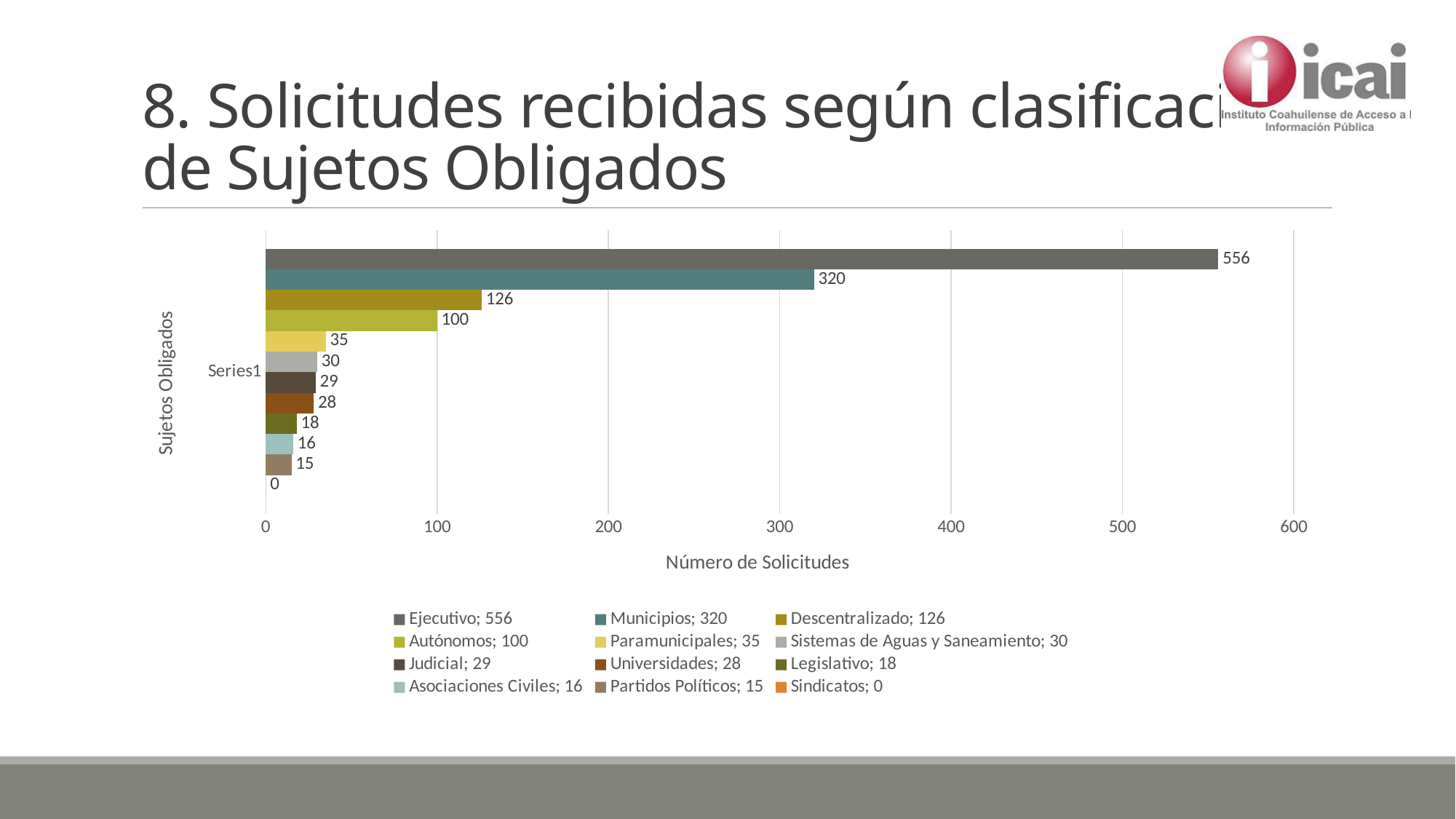
Which is larger, the value for Legislativo or the value for Asociaciones Civiles? Legislativo What is the value for Municipios? 320 What is the difference between the values for Ejecutivo and Municipios? 236 How many solicitudes were received by Ejecutivo? 556 What is the difference between the values for Descentralizado and Autónomos? 26 What is the value for Paramunicipales? 35 What is the value for Sindicatos? 0 How many categories does the legend list? 12 Is the value for Municipios greater or less than 300? greater Which category has the lowest number of solicitudes? Sindicatos What kind of chart is shown on the slide? bar chart Which category has the highest number of solicitudes? Ejecutivo